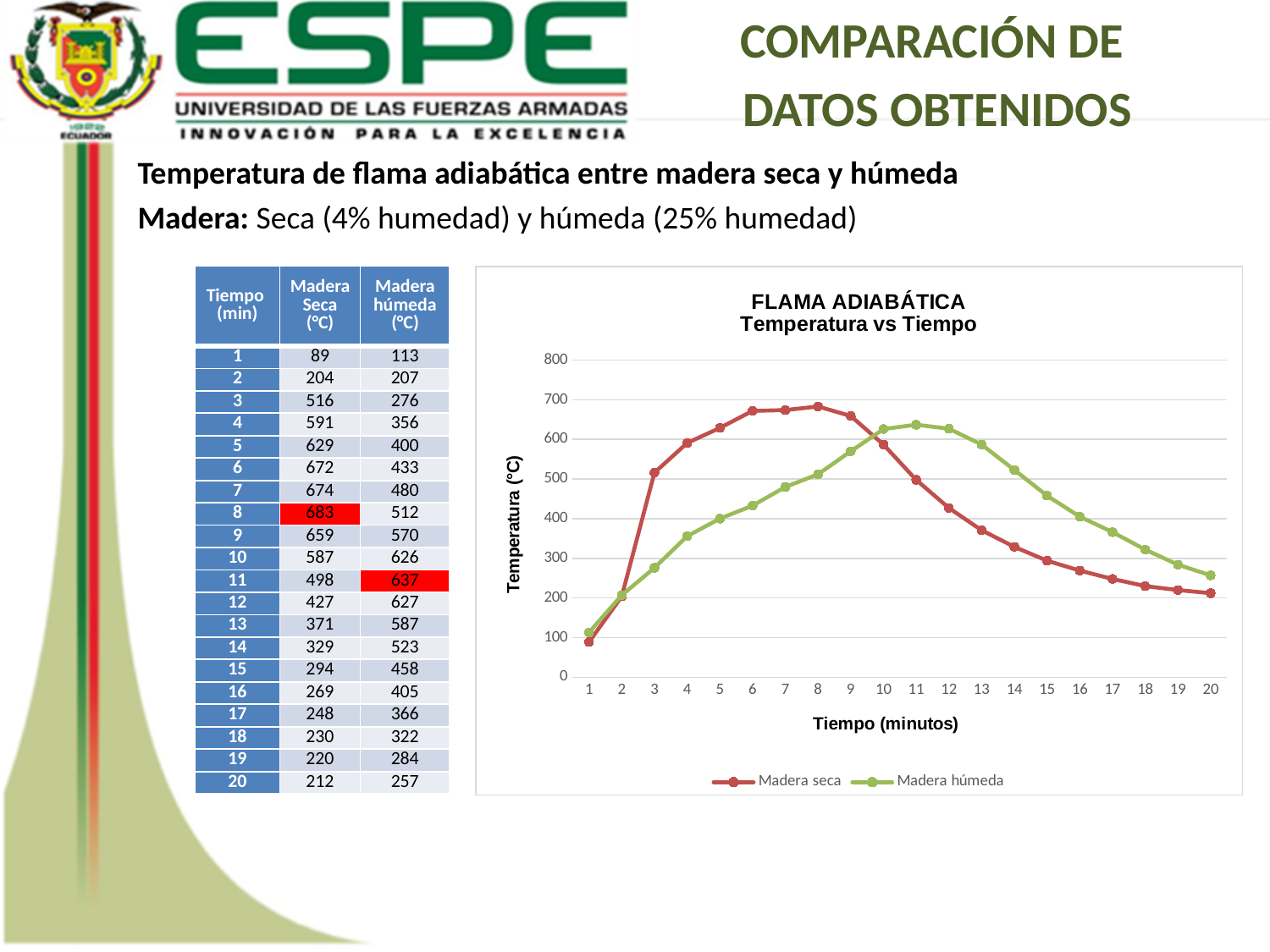
What kind of chart is the FLAMA ADIABÁTICA chart? line chart What is the temperature of Madera húmeda at minute 11? 637 How many series does the legend of the FLAMA ADIABÁTICA chart list? 2 From minute 8 to minute 20, does the Madera seca series rise or fall? fall At minute 5, which series has the higher temperature, Madera seca or Madera húmeda? Madera seca What is the temperature of Madera seca at minute 8? 683 At which minute does the Madera seca series reach its highest temperature? 8 Is the value for Madera húmeda at minute 3 greater or less than 300? less At which minute does the Madera húmeda series reach its highest temperature? 11 What is the difference between the peak temperature of Madera seca (683) and the peak temperature of Madera húmeda (637)? 46 What is the title of the x axis of the FLAMA ADIABÁTICA chart? Tiempo (minutos) How many time points are plotted along the x axis of the FLAMA ADIABÁTICA chart? 20